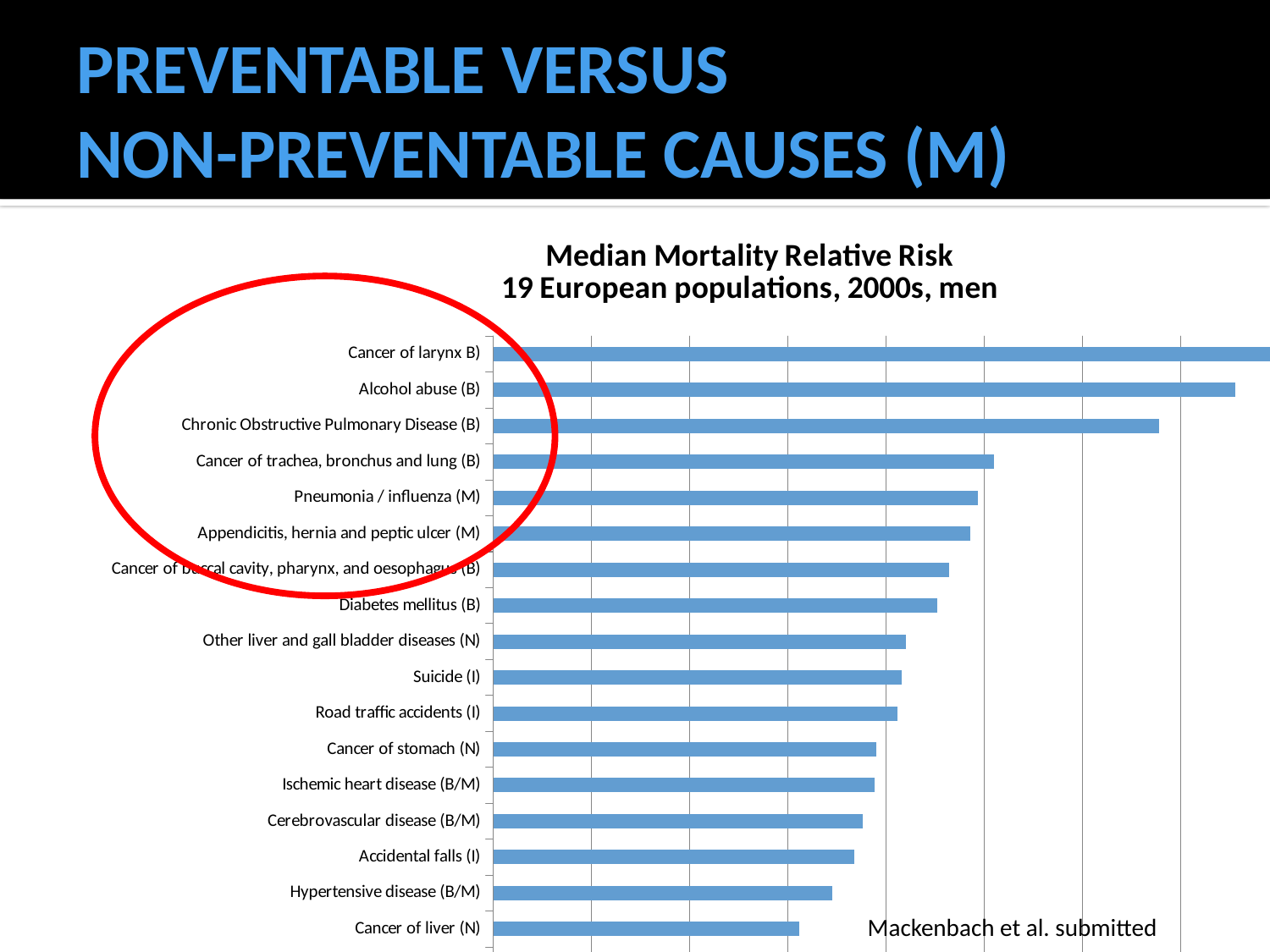
Which has a larger median mortality relative risk: Cancer of trachea, bronchus and lung (B) or Cancer of stomach (N)? Cancer of trachea, bronchus and lung (B) What kind of chart is shown on the slide? Bar chart Which cause of death has the highest median mortality relative risk? Cancer of larynx B) Which has a larger median mortality relative risk: Diabetes mellitus (B) or Hypertensive disease (B/M)? Diabetes mellitus (B) Which has a larger median mortality relative risk: Alcohol abuse (B) or Chronic Obstructive Pulmonary Disease (B)? Alcohol abuse (B) Do the bar lengths increase or decrease going from the top of the chart to the bottom? Decrease What is the title of the chart? Median Mortality Relative Risk 19 European populations, 2000s, men Which cause of death has the second-highest median mortality relative risk? Alcohol abuse (B) What colour are the bars in the chart? Blue